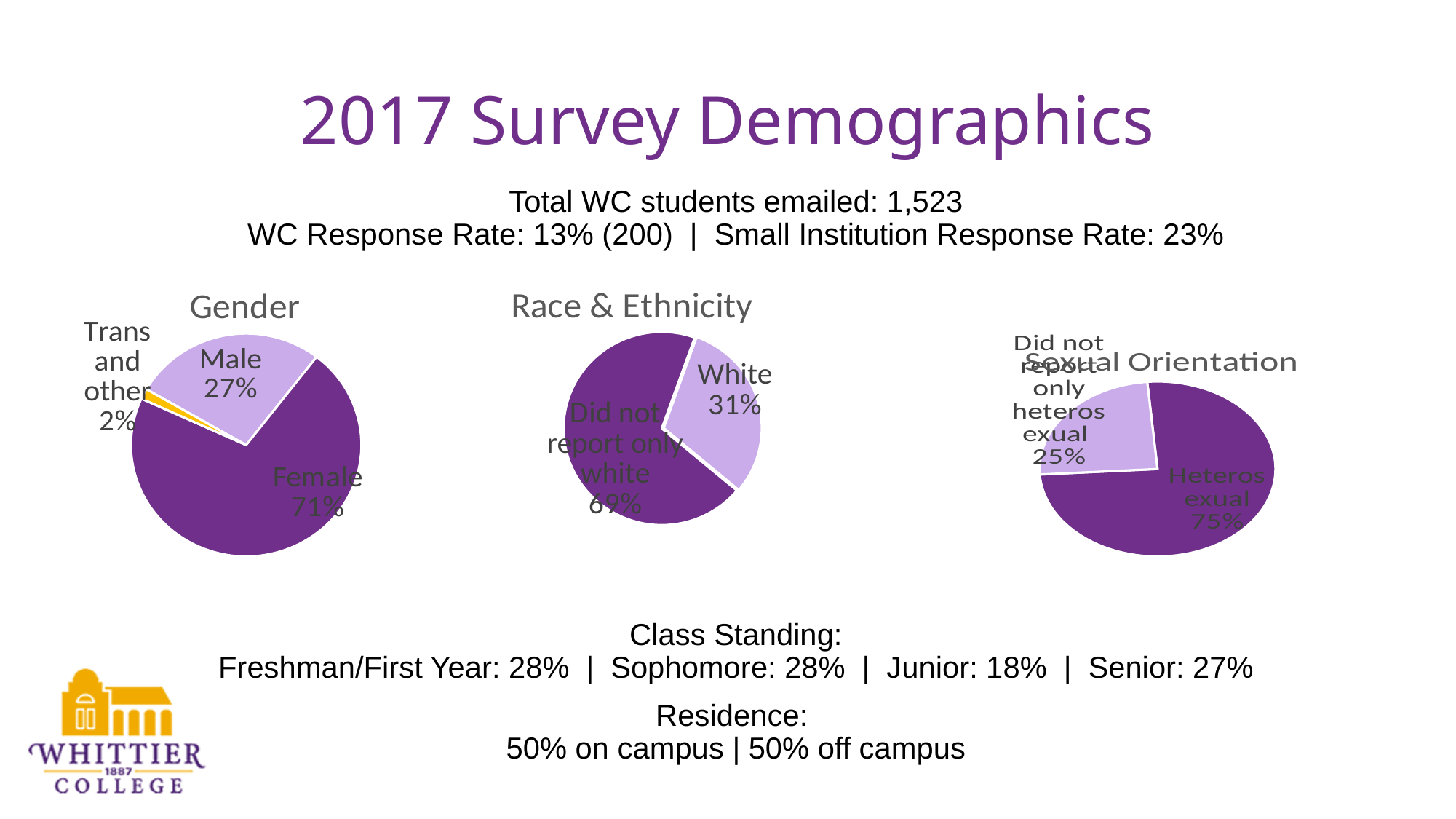
In the Gender chart, what is the difference between the Female and Male shares? 44 percentage points In the Sexual Orientation chart, what share did not report only heterosexual? 25% How many slices does the Gender chart have? 3 In the Race & Ethnicity chart, which slice is larger: White or Did not report only white? Did not report only white In the Race & Ethnicity chart, what share of respondents are White? 31% What type of chart is the Race & Ethnicity chart? Pie chart In the Sexual Orientation chart, what share of respondents are Heterosexual? 75% In the Gender chart, which category has the smallest slice? Trans and other In the Race & Ethnicity chart, what share did not report only white? 69% In the Gender chart, what share of respondents are Trans and other? 2% In the Gender chart, what share of respondents are Male? 27% In the Gender chart, what share of respondents are Female? 71%